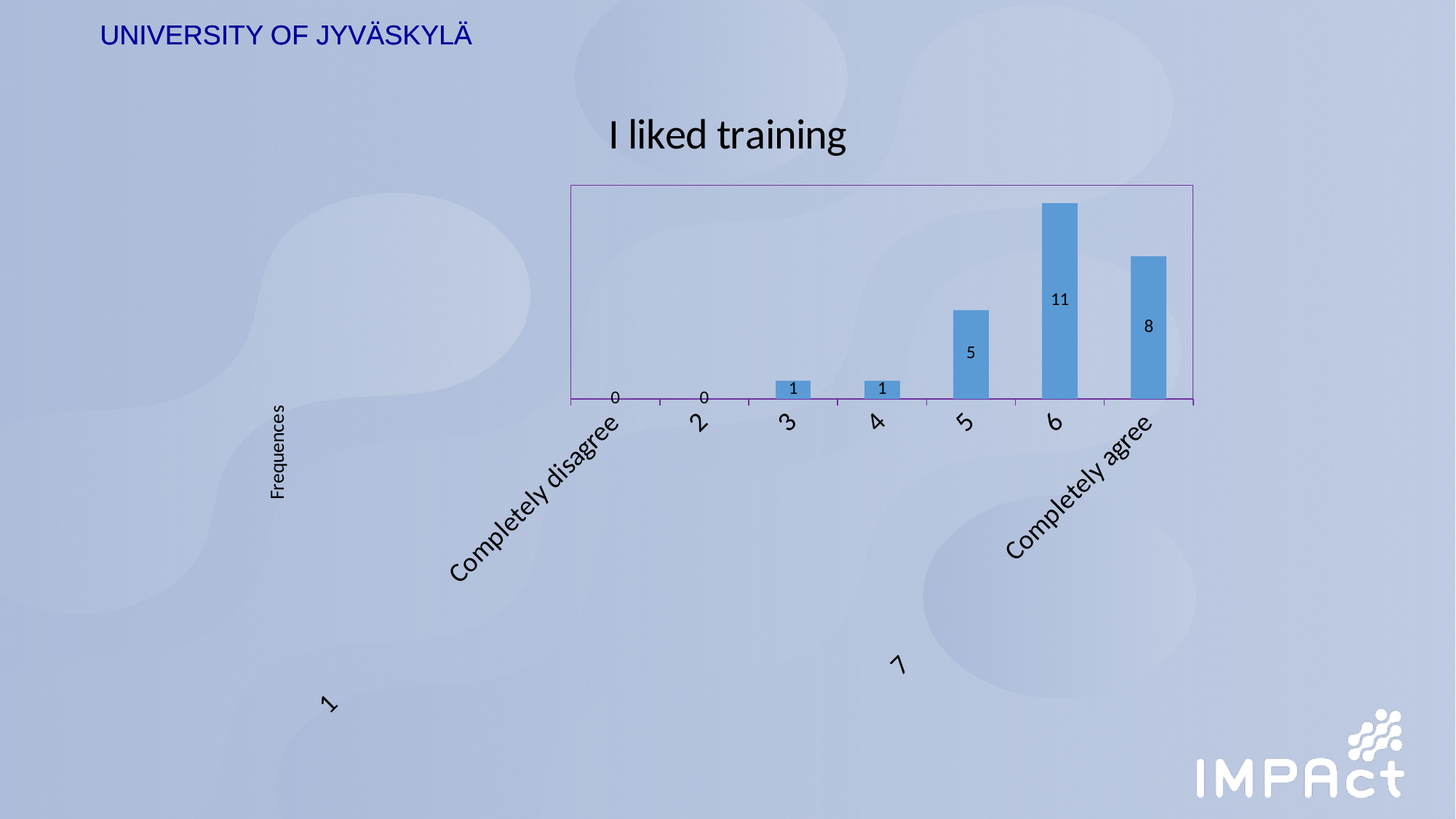
What kind of chart is shown on the slide? Bar chart What is the value for "Completely disagree" in the "I liked training" chart? 0 What is the value for "Completely agree" in the "I liked training" chart? 8 What is the title of the chart on the slide? I liked training What is the difference between the values for category 6 and "Completely agree"? 3 What is the value for category 6 in the "I liked training" chart? 11 Which category has the highest value in the "I liked training" chart? 6 How many categories are shown on the x axis of the "I liked training" chart? 7 What is the value for category 5 in the "I liked training" chart? 5 Which is larger, the value for category 5 or the value for "Completely agree"? Completely agree What is the difference between the values for category 5 and category 4? 4 What is the label of the vertical axis of the chart? Frequences